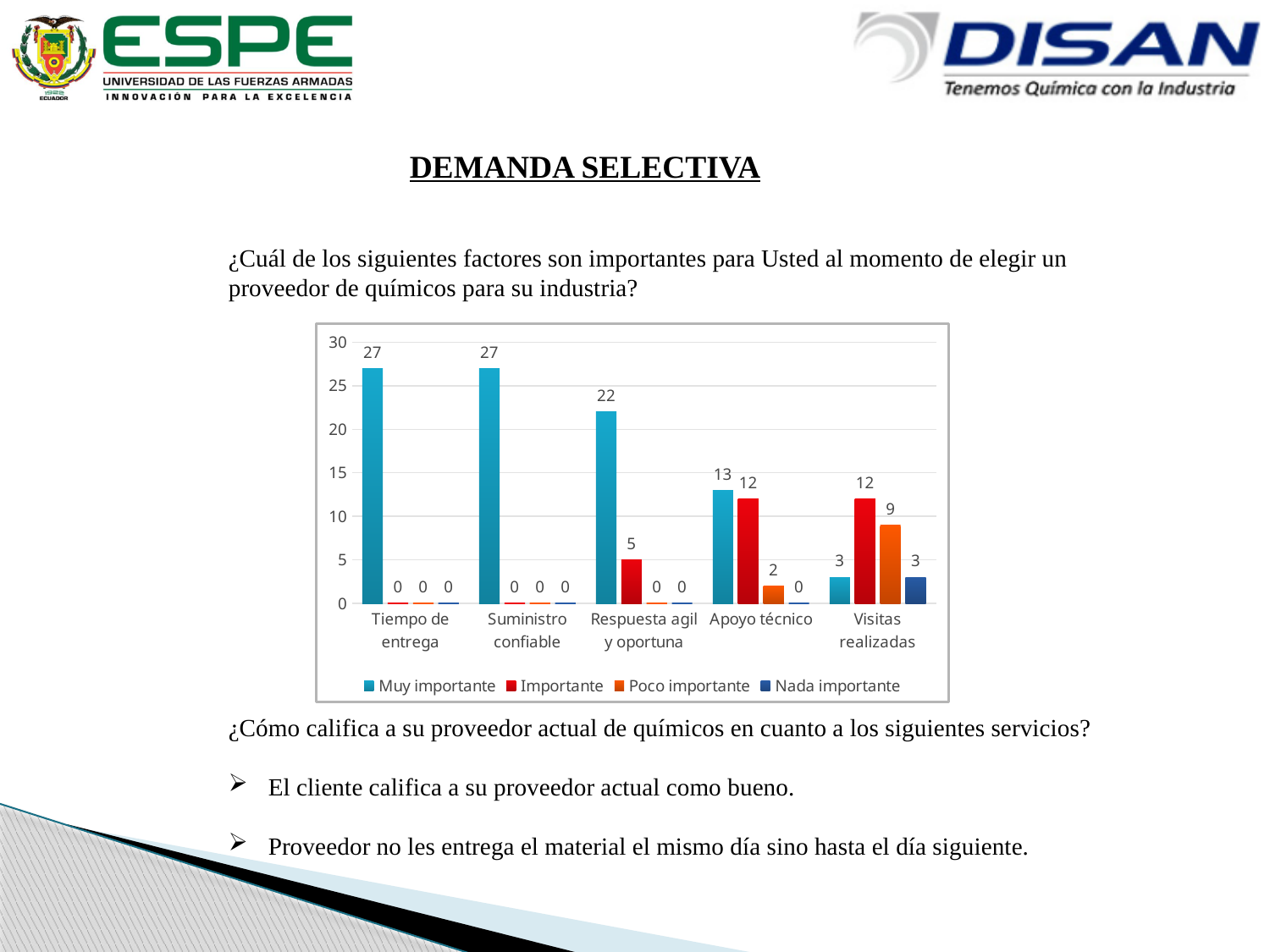
Does the 'Muy importante' value rise or fall across the categories from left to right? fall What is the difference between the 'Muy importante' values for 'Tiempo de entrega' and 'Apoyo técnico'? 14 What is the 'Importante' value for 'Apoyo técnico'? 12 Which category has the highest 'Poco importante' value? Visitas realizadas Which is larger: the 'Muy importante' value for 'Apoyo técnico' or the 'Importante' value for 'Visitas realizadas'? Muy importante for Apoyo técnico What is the 'Poco importante' value for 'Visitas realizadas'? 9 Which category has the lowest 'Muy importante' value? Visitas realizadas What type of chart is shown on the slide? bar chart How many categories are shown on the x axis of the chart? 5 Which series is shown in orange in the chart legend? Poco importante What is the 'Muy importante' value for 'Respuesta agil y oportuna'? 22 How many series does the chart legend list? 4